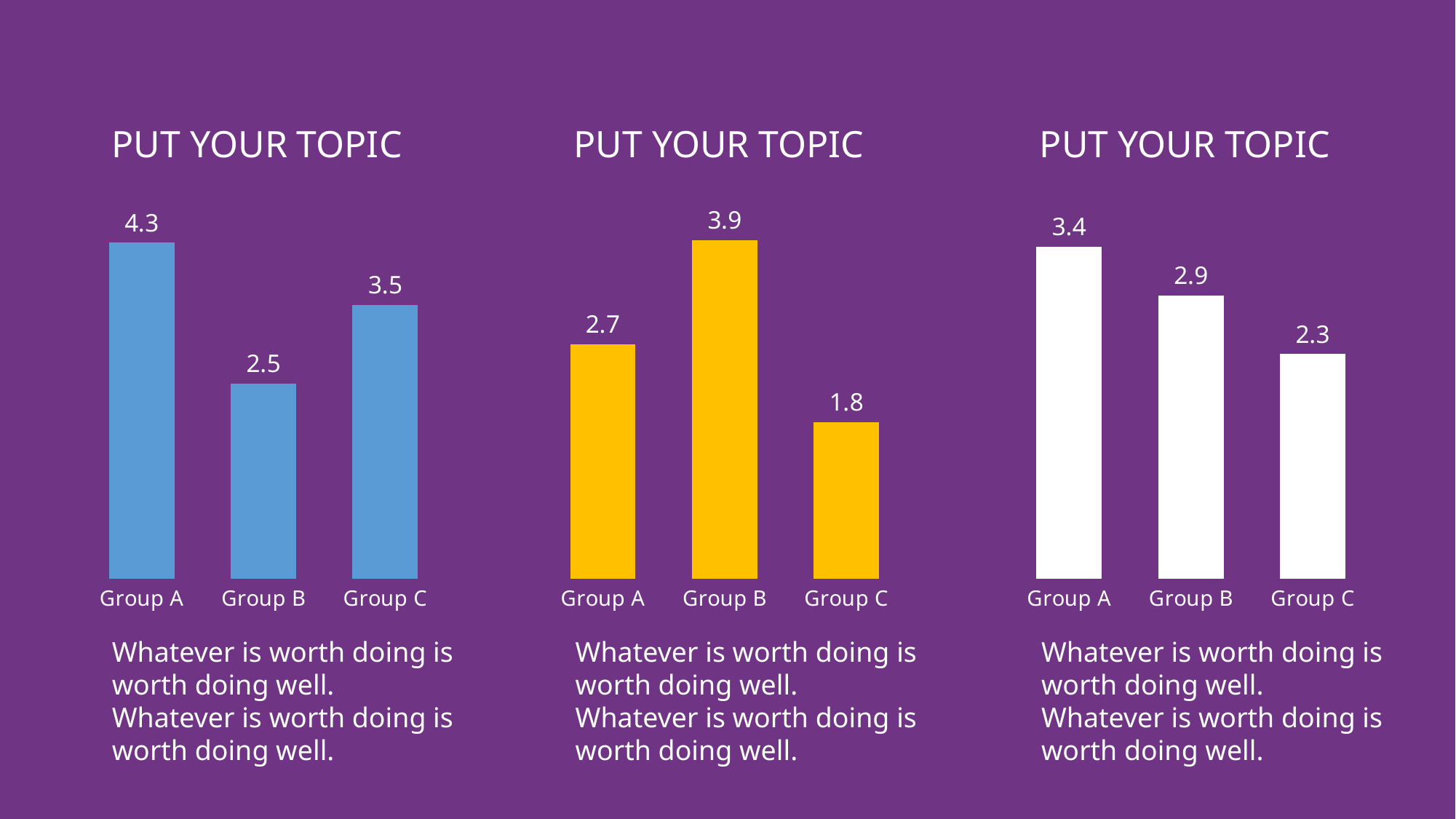
In the middle chart, which group has the highest value? Group B In the middle chart, what is the value for Group C? 1.8 In the left chart, which group has the lowest value? Group B Do the values in the right chart rise or fall from Group A to Group C? Fall In the right chart, which is larger, the value for Group B or Group C? Group B In the middle chart, what is the difference between the values for Group B and Group C? 2.1 What kind of chart is the left chart? Bar chart How many bars does the middle chart have? 3 In the right chart, which group has the highest value? Group A In the right chart, what is the value for Group B? 2.9 In the left chart, what is the difference between the values for Group A and Group C? 0.8 In the left chart, what is the value for Group A? 4.3